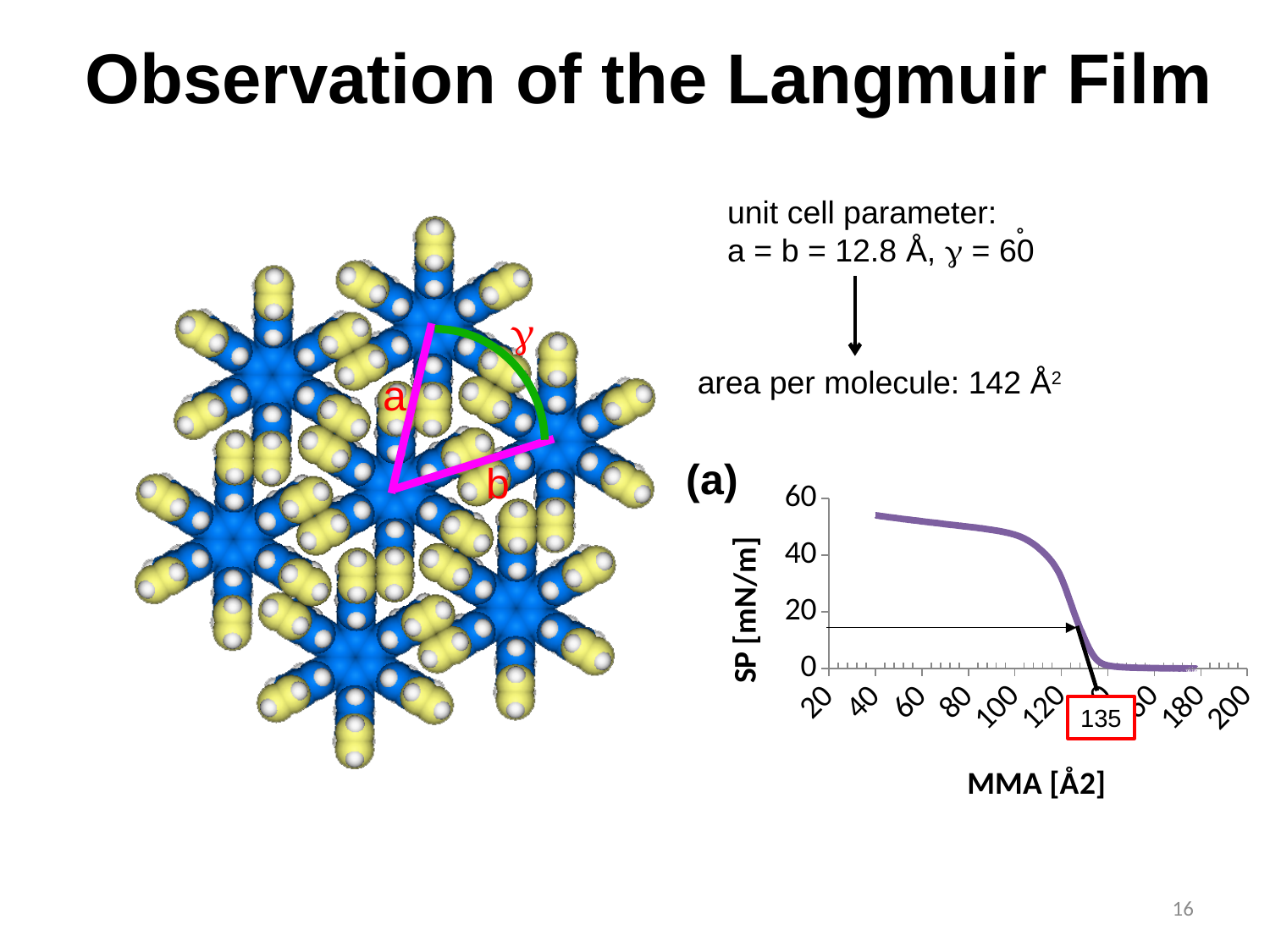
Is the SP value at MMA 180 greater or less than 20? less What kind of chart is shown on the slide? line chart What is the highest tick value shown on the y axis of the chart? 60 Is the SP value at MMA 60 greater or less than 60? less Which is larger, the SP value at MMA 40 or the SP value at MMA 160? MMA 40 What is the label of the y axis of the chart? SP [mN/m] What MMA value is called out in the red box annotation on the chart? 135 Does the SP value rise or fall as MMA increases along the x axis? fall Is the SP value at MMA 100 greater or less than 20? greater What is the highest tick value shown on the x axis of the chart? 200 What is the label of the x axis of the chart? MMA [Å2]